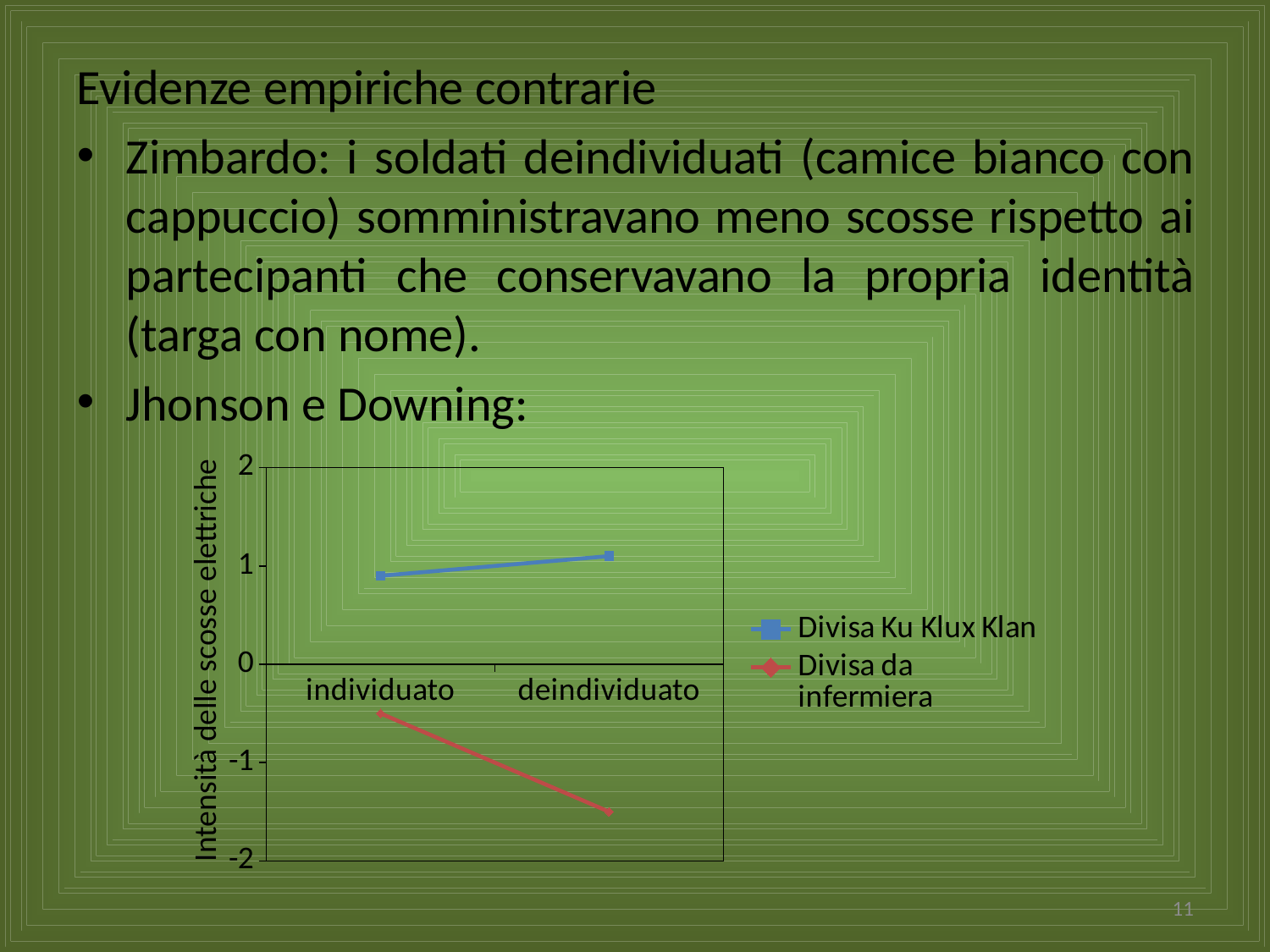
At deindividuato, which series has the larger value: Divisa Ku Klux Klan or Divisa da infermiera? Divisa Ku Klux Klan What is the label of the vertical axis of the chart? Intensità delle scosse elettriche Does the value for Divisa da infermiera rise or fall from individuato to deindividuato? fall Does the value for Divisa Ku Klux Klan rise or fall from individuato to deindividuato? rise What kind of chart is shown on the slide? line chart How many categories are shown on the x axis of the chart? 2 For Divisa da infermiera, which category has the larger value: individuato or deindividuato? individuato Is the value for Divisa da infermiera at deindividuato greater or less than -1? less How many series does the legend of the chart list? 2 Which series is drawn in blue in the chart? Divisa Ku Klux Klan Is the value for Divisa da infermiera at individuato greater or less than -1? greater Is the value for Divisa Ku Klux Klan at individuato greater or less than 0? greater